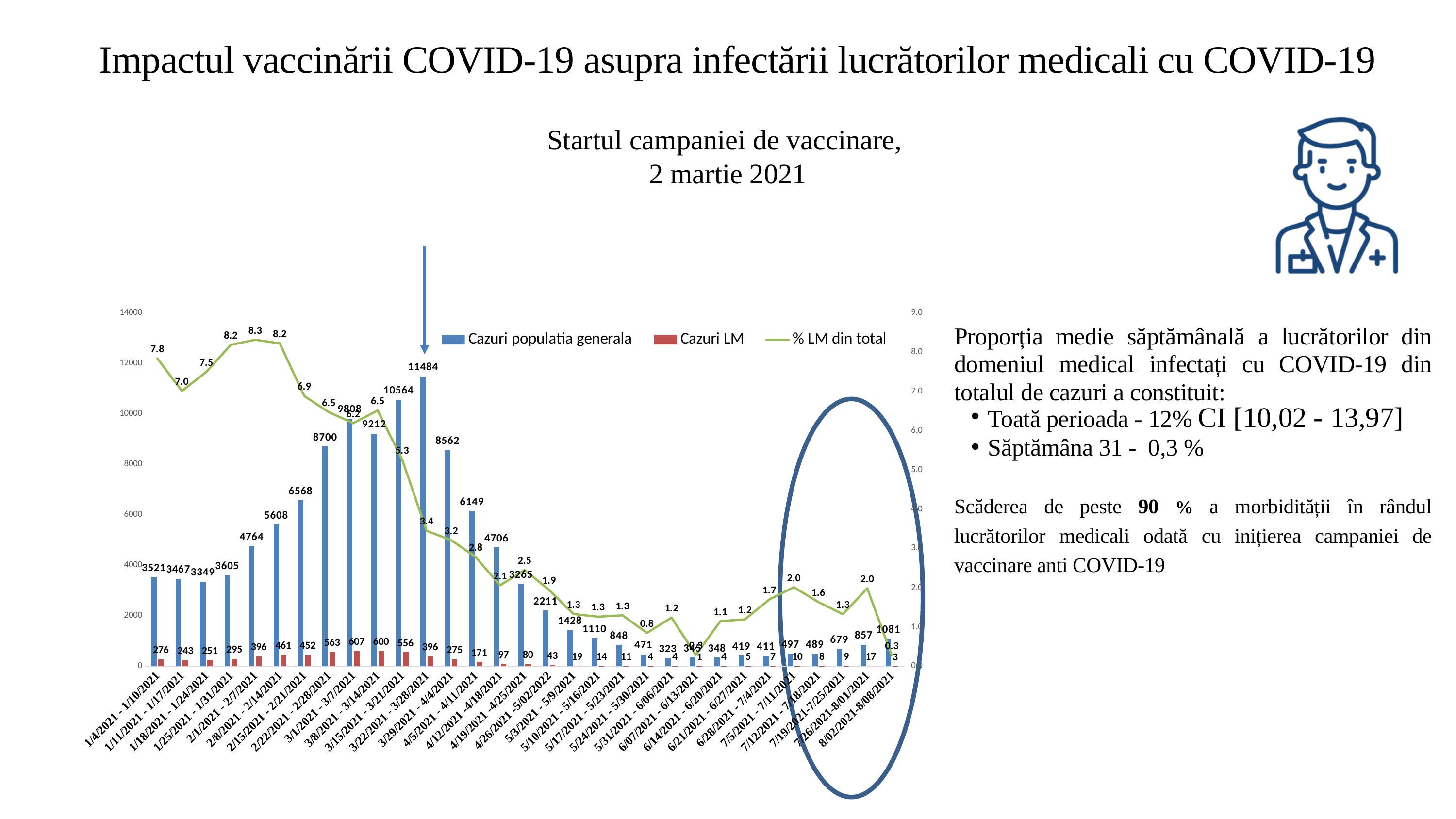
What is the value of Cazuri populatia generala for the week 7/26/2021-8/01/2021? 857 What is the value of Cazuri populatia generala for the week 3/22/2021 - 3/28/2021? 11484 Which week has the larger value for Cazuri LM: 1/4/2021 - 1/10/2021 or 1/11/2021 - 1/17/2021? 1/4/2021 - 1/10/2021 How many series does the chart legend list? 3 What is the value of Cazuri LM for the week 3/1/2021 - 3/7/2021? 607 What is the difference in Cazuri populatia generala between the weeks 3/22/2021 - 3/28/2021 and 3/29/2021 - 4/4/2021? 2922 Which week has the highest value for % LM din total? 2/1/2021 - 2/7/2021 What is the value of % LM din total for the week 8/02/2021-8/08/2021? 0.3 How many weekly categories are shown on the x axis of the chart? 31 Which week has the highest value for Cazuri populatia generala? 3/22/2021 - 3/28/2021 Does the % LM din total line generally rise or fall from the first week to the last week? Fall What kind of chart is shown on the slide? A combination bar and line chart